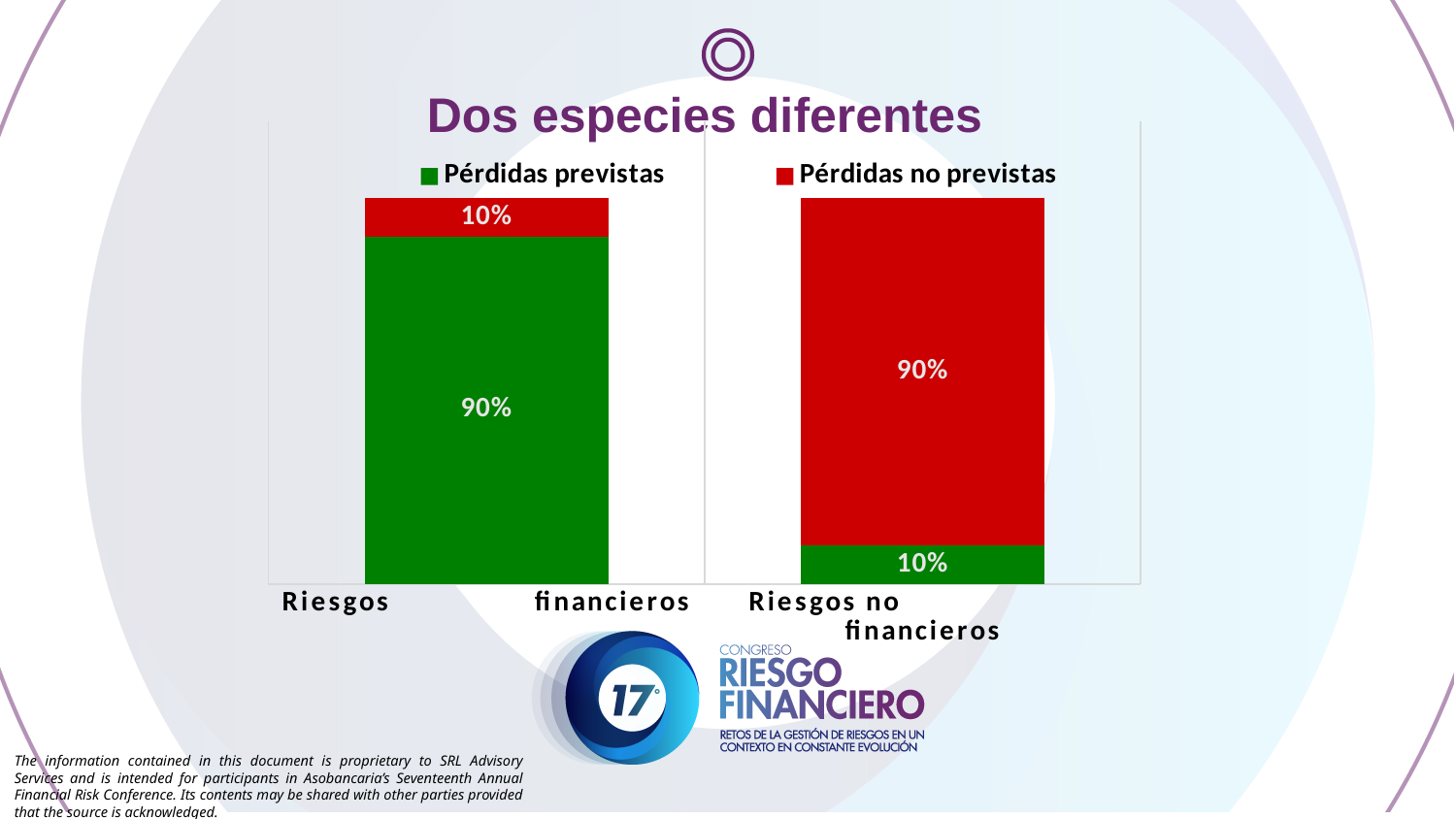
What is the total of the stacked bar for Riesgos no financieros? 100% What kind of chart is shown on the slide? Stacked bar chart Which category has the higher value for Pérdidas previstas? Riesgos financieros What is the value of Pérdidas no previstas for Riesgos no financieros? 90% For Riesgos no financieros, which is larger: Pérdidas previstas or Pérdidas no previstas? Pérdidas no previstas What is the value of Pérdidas previstas for Riesgos financieros? 90% What is the value of Pérdidas no previstas for Riesgos financieros? 10% What is the value of Pérdidas previstas for Riesgos no financieros? 10% What is the difference between Pérdidas previstas and Pérdidas no previstas for Riesgos financieros? 80% Which category has the lower value for Pérdidas no previstas? Riesgos financieros How many categories are shown on the x axis? 2 How many series does the legend list? 2